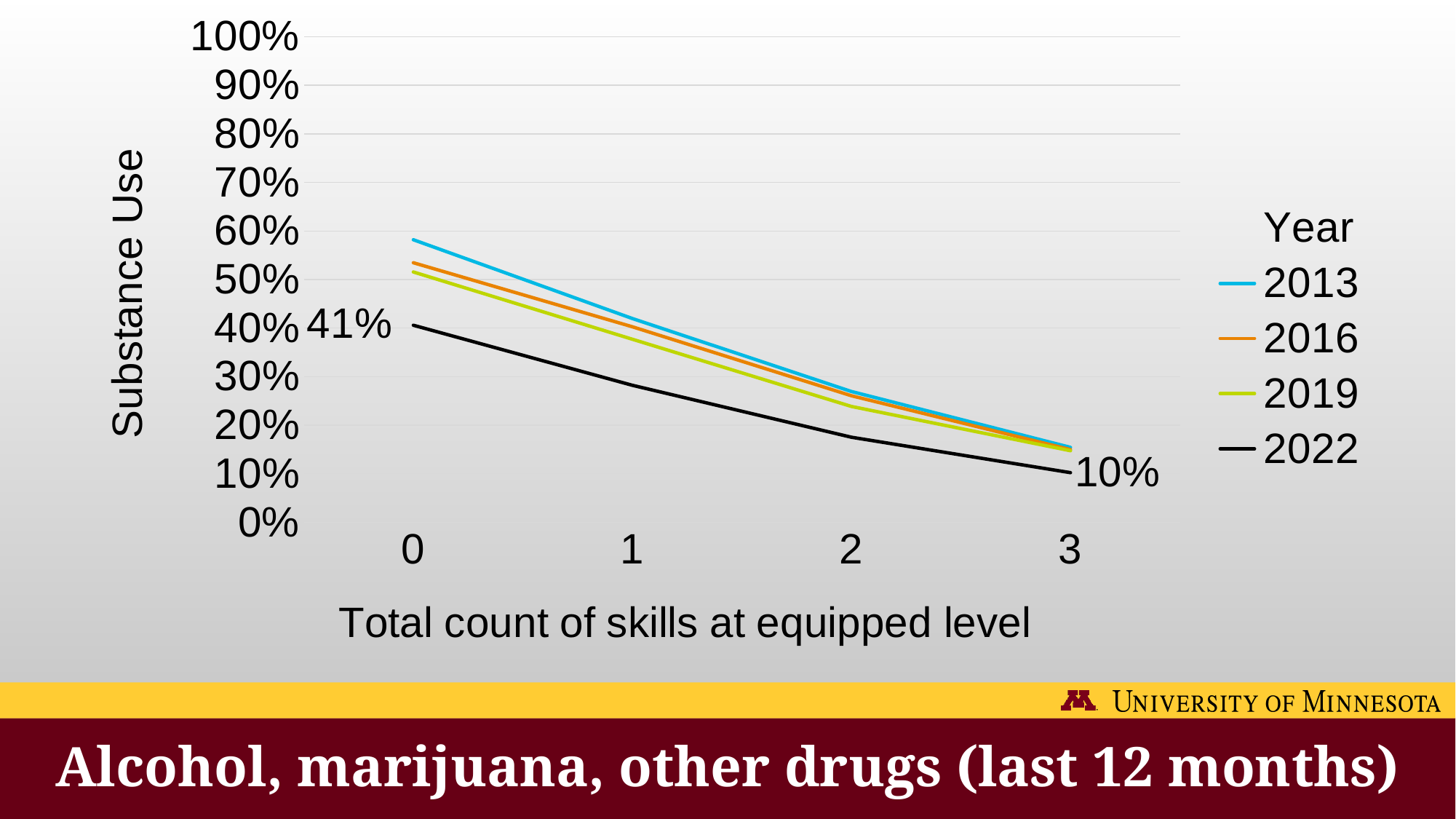
What is the substance use value for 2022 at a total count of 0 skills at equipped level? 41% What type of chart is shown on the slide? line chart Which year has the lowest substance use at a total count of 0 skills? 2022 Is the value for 2013 at 0 skills greater or less than 50%? greater Do the substance use values rise or fall as the total count of skills at equipped level increases? fall Is the value for 2013 at 3 skills greater or less than 20%? less What is the substance use value for 2022 at a total count of 3 skills at equipped level? 10% Which year has the highest substance use at a total count of 0 skills? 2013 How many points on the x axis (total count of skills at equipped level) are plotted? 4 How many series does the legend list? 4 By how many percentage points does the 2022 value drop from 0 skills to 3 skills at equipped level? 31 percentage points At 0 skills at equipped level, which is larger: the value for 2013 or the value for 2022? 2013